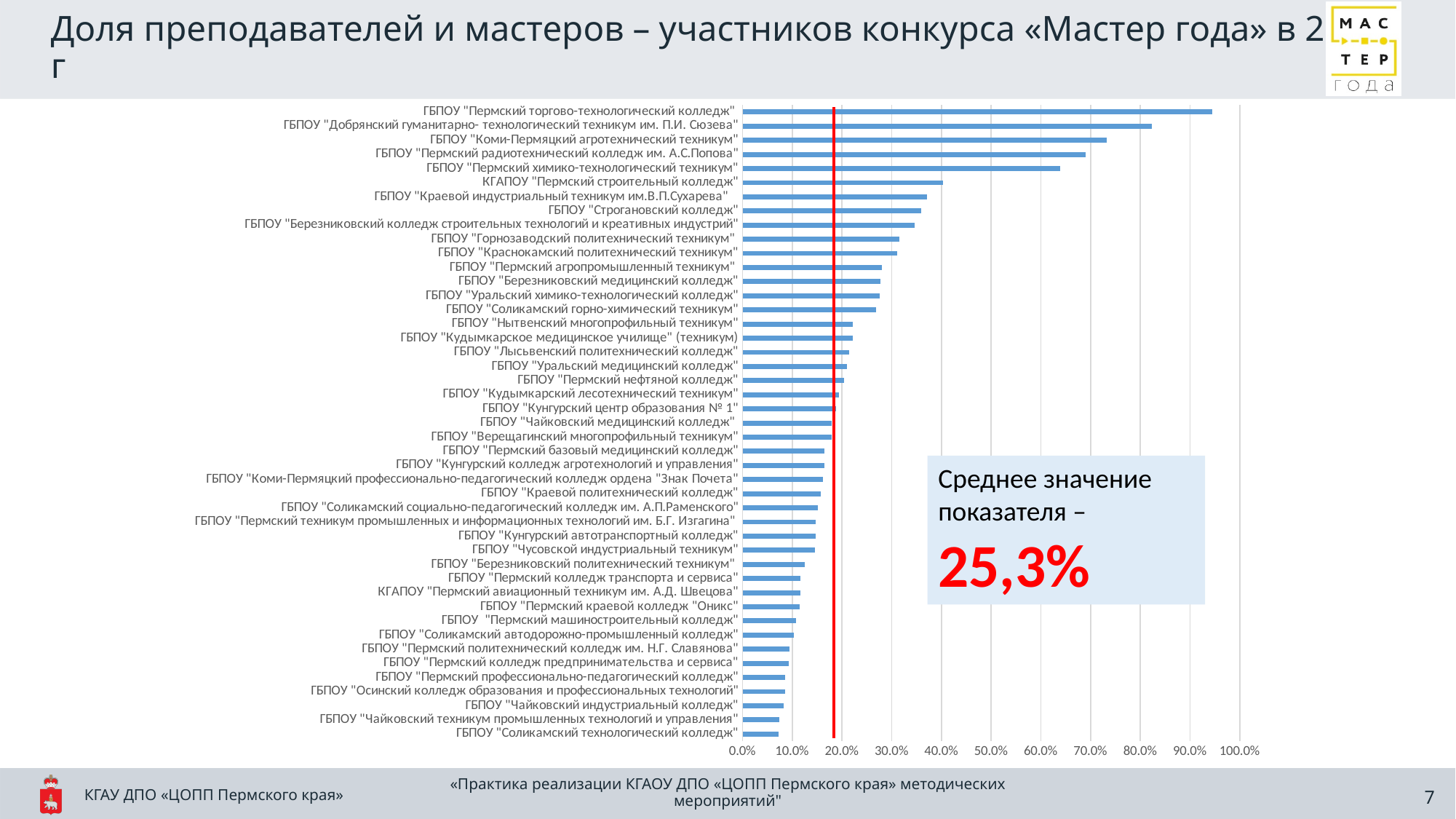
What average value of the indicator is stated on the slide? 25,3% Is the value for ГБПОУ "Пермский агропромышленный техникум" greater or less than 30.0%? less Is the value for ГБПОУ "Пермский торгово-технологический колледж" greater or less than 90.0%? greater What kind of chart is shown on the slide? bar chart Do the bar values increase or decrease going from the top of the chart to the bottom? decrease Which has the larger value: ГБПОУ "Строгановский колледж" or ГБПОУ "Краснокамский политехнический техникум"? ГБПОУ "Строгановский колледж" Which institution has the highest value in the chart? ГБПОУ "Пермский торгово-технологический колледж" Is the value for ГБПОУ "Добрянский гуманитарно-технологический техникум им. П.И. Сюзева" greater or less than 80.0%? greater Which has the larger value: ГБПОУ "Добрянский гуманитарно-технологический техникум им. П.И. Сюзева" or ГБПОУ "Коми-Пермяцкий агротехнический техникум"? ГБПОУ "Добрянский гуманитарно-технологический техникум им. П.И. Сюзева"